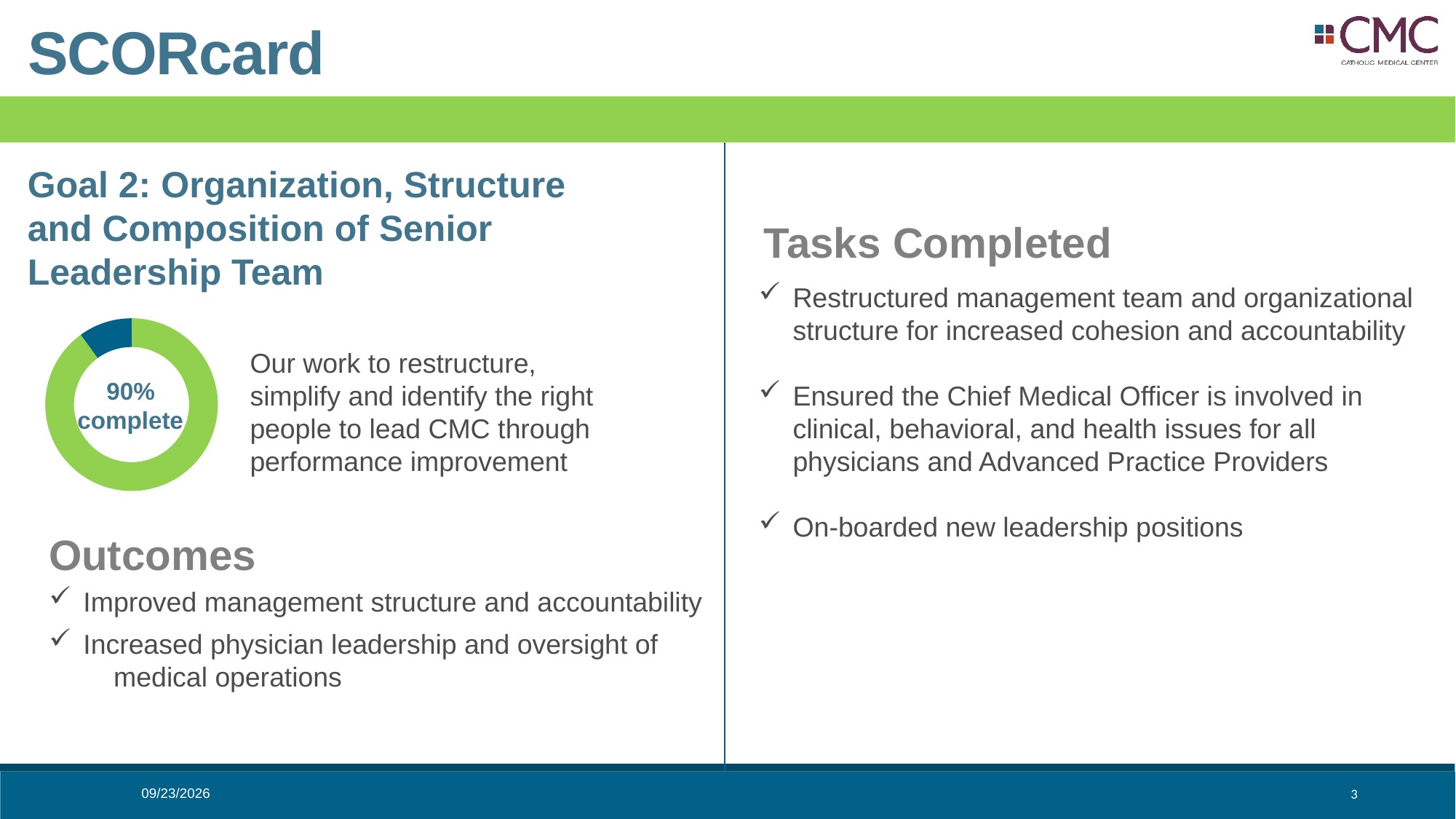
How many segments does the doughnut chart have? 2 Is the completed share shown in the doughnut chart greater or less than 50%? greater What colour is the larger segment of the doughnut chart? Green What share of the doughnut chart does the completed portion represent? 90% What percentage complete does the doughnut chart show? 90% complete Which segment of the doughnut chart is larger, the green one or the dark blue one? The green one What text is printed in the centre of the doughnut chart? 90% complete What kind of chart is shown on the slide? Doughnut chart